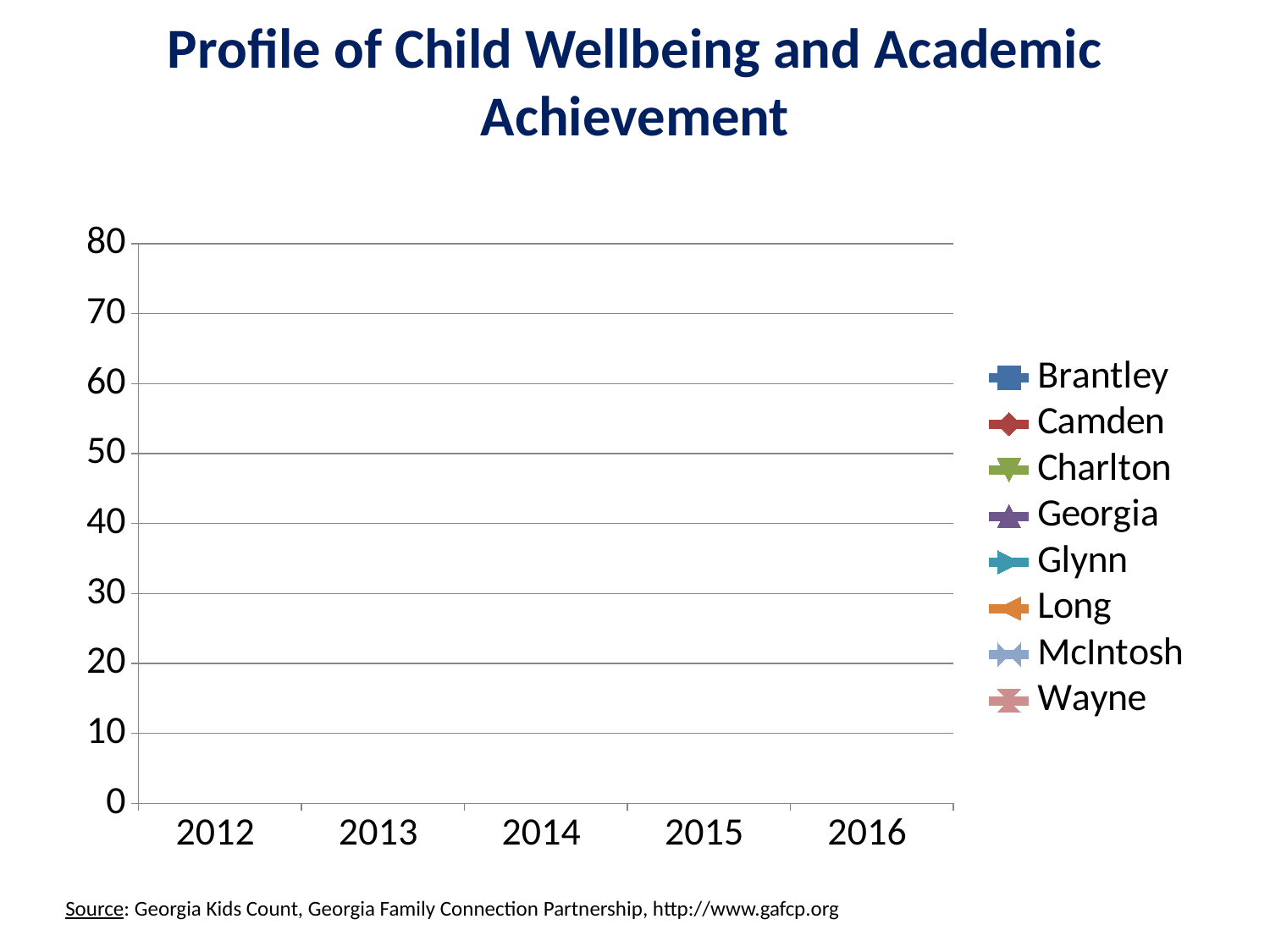
What is the first year shown on the x axis? 2012 How many series does the legend list? 8 How many years are shown on the x axis? 5 What is the title of the chart? Profile of Child Wellbeing and Academic Achievement What is the highest value shown on the y axis? 80 Which series is listed first in the legend? Brantley What is the last year shown on the x axis? 2016